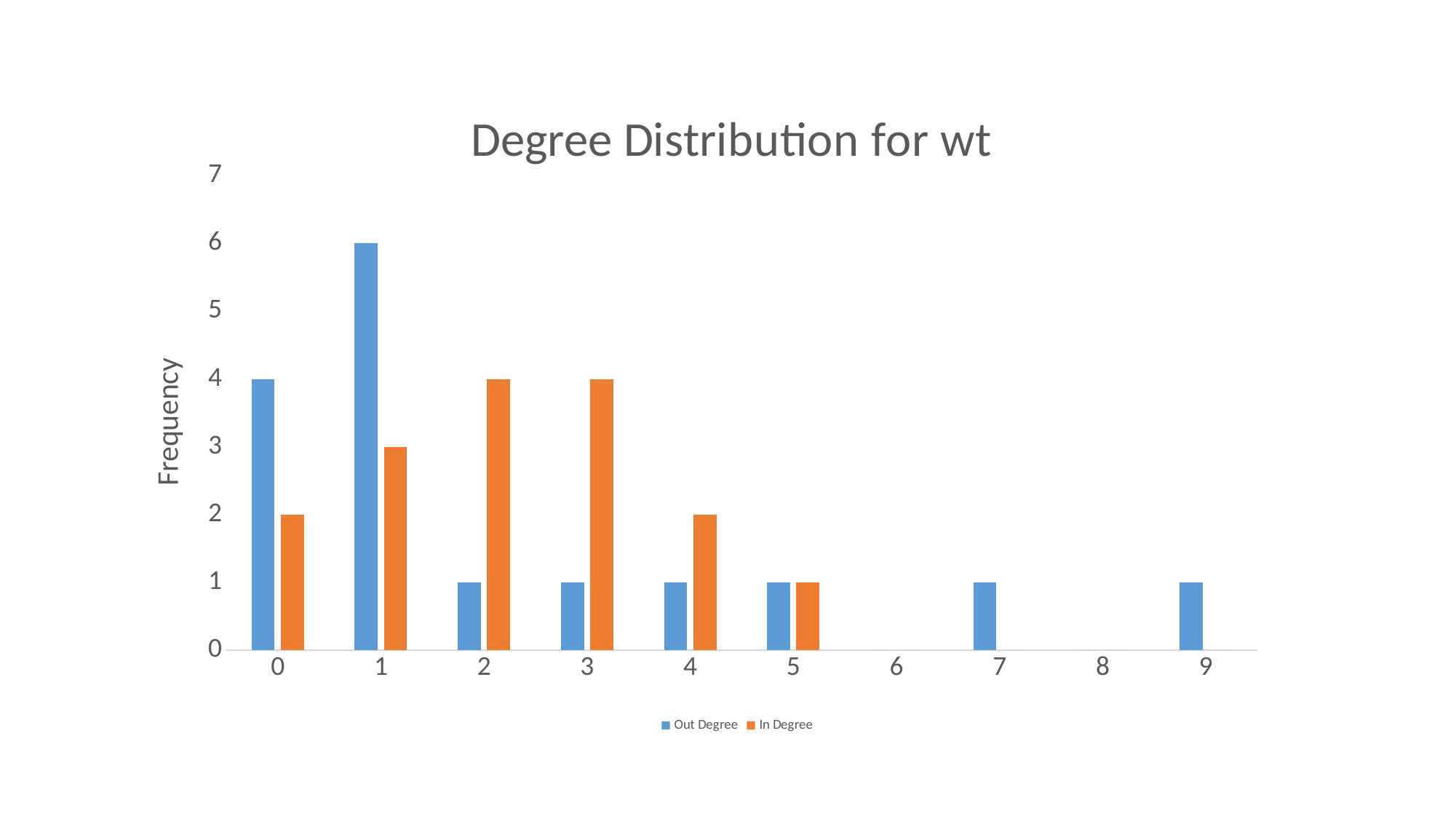
What is the In Degree frequency at degree 1? 3 At which degree is the Out Degree frequency highest? 1 What is the Out Degree frequency at degree 1? 6 How many degree categories are shown on the x axis? 10 What is the title of the chart? Degree Distribution for wt What is the In Degree frequency at degree 2? 4 At degree 3, which series has the larger frequency, Out Degree or In Degree? In Degree What kind of chart is shown on the slide? Bar chart Is the Out Degree frequency at degree 1 greater or less than 5? greater What is the difference between the Out Degree and In Degree frequencies at degree 0? 2 How many series does the legend list? 2 What is the Out Degree frequency at degree 0? 4